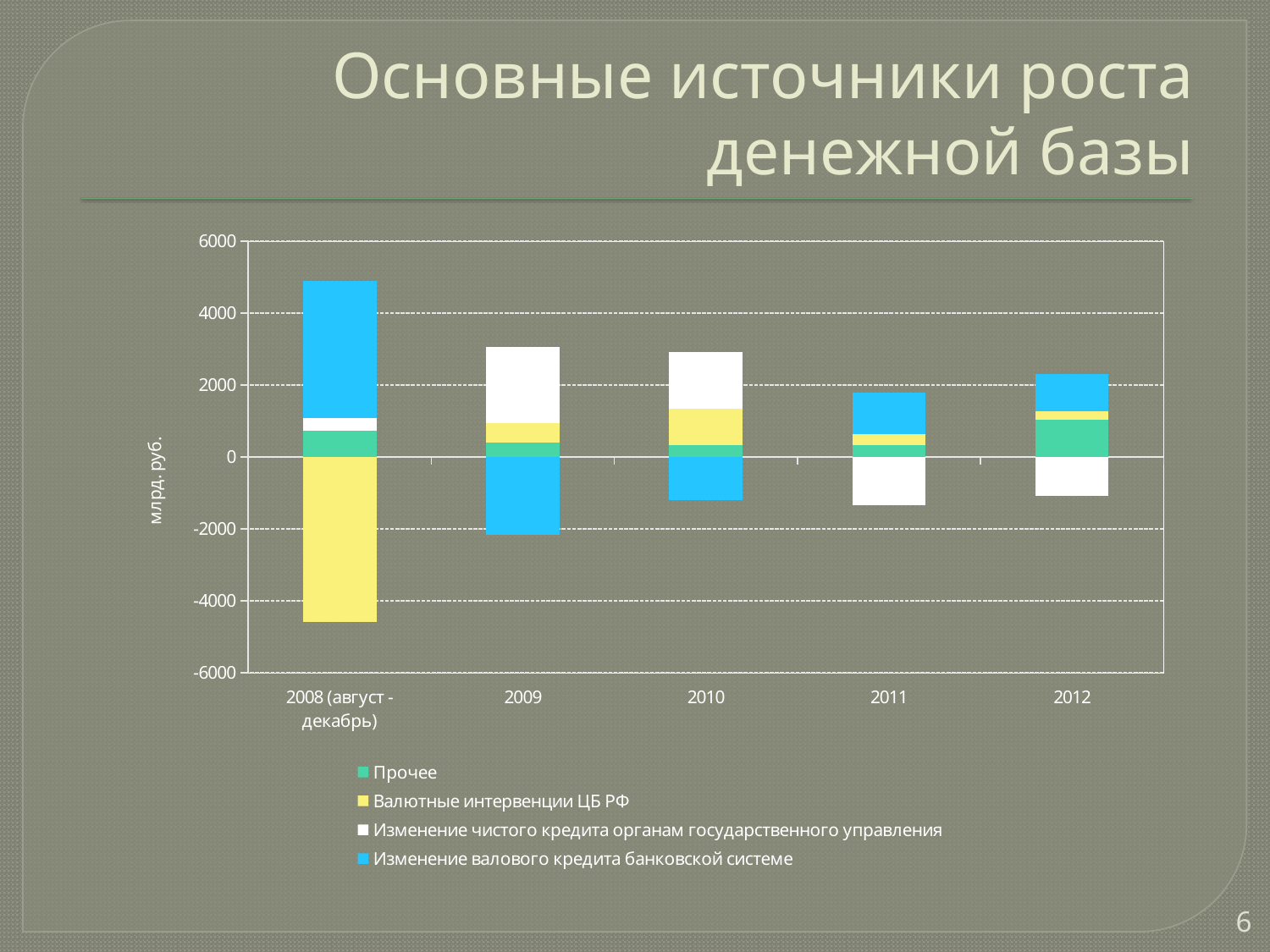
Is the value for Изменение валового кредита банковской системе in 2009 greater or less than -1000? less Is the value for Валютные интервенции ЦБ РФ in 2008 (август - декабрь) greater or less than -4000? less What kind of chart is shown on the slide? Stacked bar chart What unit is shown on the vertical axis of the chart? млрд. руб. Which year has the larger value for Валютные интервенции ЦБ РФ, 2010 or 2011? 2010 How many series does the chart legend list? 4 Which period has the tallest positive stacked bar in the chart? 2008 (август - декабрь) What is the title of the slide containing the chart? Основные источники роста денежной базы Which series has a negative value in 2008 (август - декабрь)? Валютные интервенции ЦБ РФ How many time periods are shown on the x axis of the chart? 5 Is the value for Изменение валового кредита банковской системе in 2008 (август - декабрь) greater or less than 2000? greater